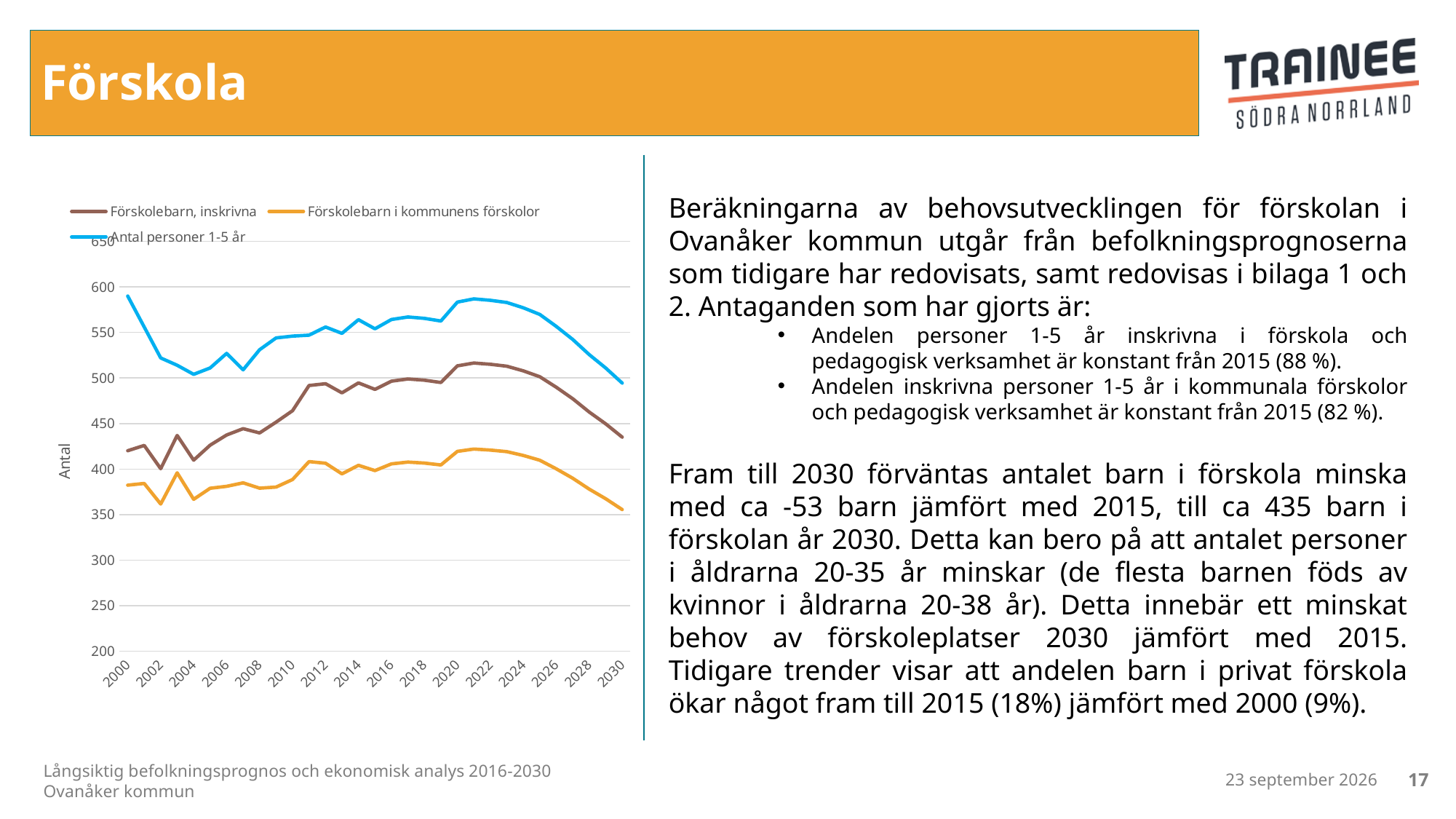
In 2020, which is larger: Antal personer 1-5 år or Förskolebarn, inskrivna? Antal personer 1-5 år Is the value for Förskolebarn i kommunens förskolor in 2030 greater or less than 400? less Is the value for Antal personer 1-5 år in 2000 greater or less than 550? greater What is the label on the chart's vertical axis? Antal Which series has the highest values across the whole chart? Antal personer 1-5 år What kind of chart is shown on the slide? Line chart Do the values for Antal personer 1-5 år rise or fall from 2022 to 2030? fall What colour is the line for Förskolebarn i kommunens förskolor? Orange Is the value for Förskolebarn, inskrivna in 2030 greater or less than 450? less How many series does the chart's legend list? 3 Which series has the lowest values across the whole chart? Förskolebarn i kommunens förskolor